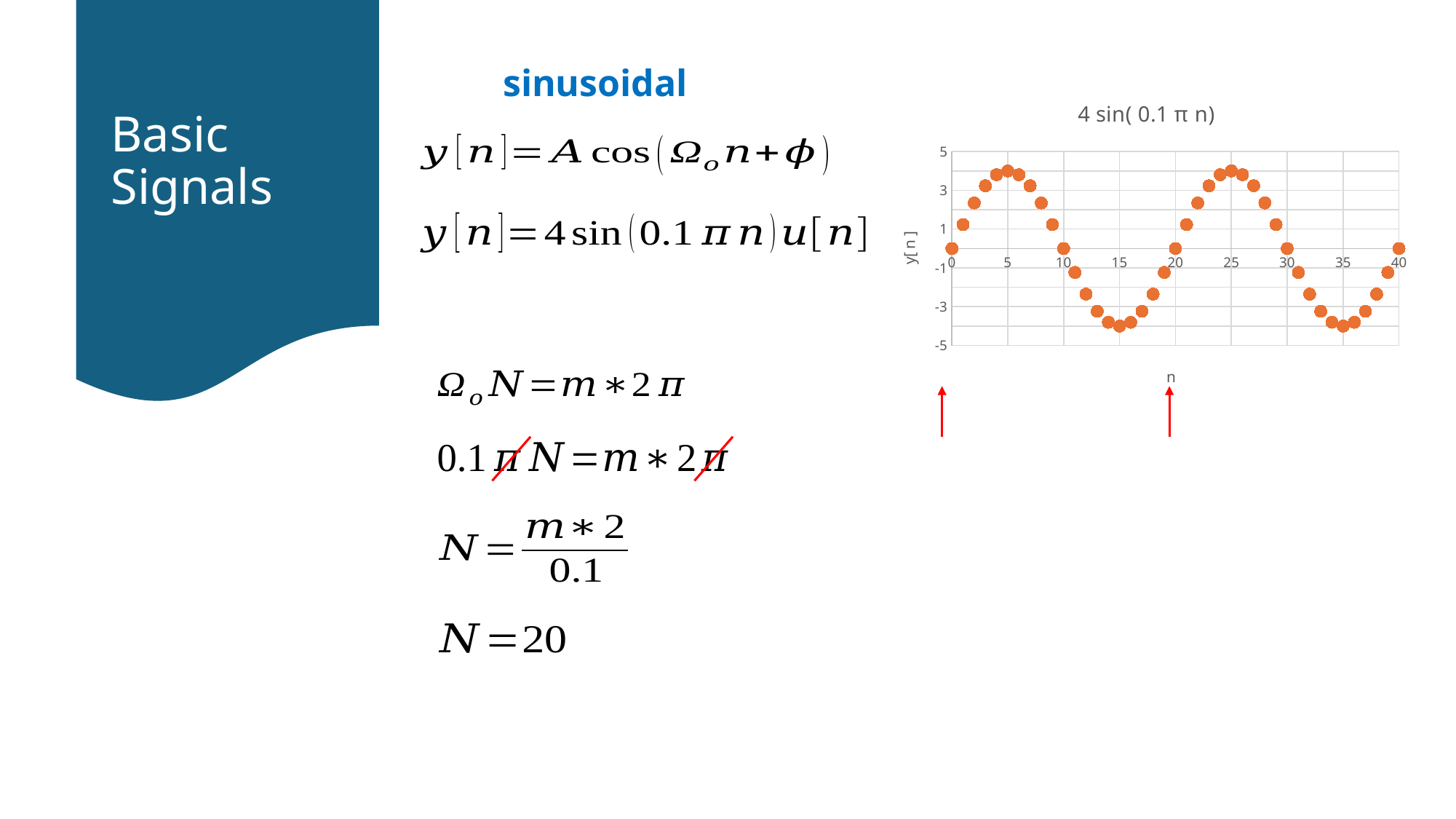
Between n = 10 and n = 20, at which n is the plotted value lowest? 15 Is the value for n = 35 greater or less than -3? less Do the plotted values rise or fall as n goes from 5 to 15? fall What is the title of the chart? 4 sin( 0.1 π n) Is the value for n = 15 greater or less than -3? less What is the label of the x axis of the chart? n Between n = 0 and n = 10, at which n is the plotted value highest? 5 Is the value for n = 5 greater or less than 3? greater What kind of chart is shown on the slide? scatter chart Which is larger, the value at n = 5 or the value at n = 15? n = 5